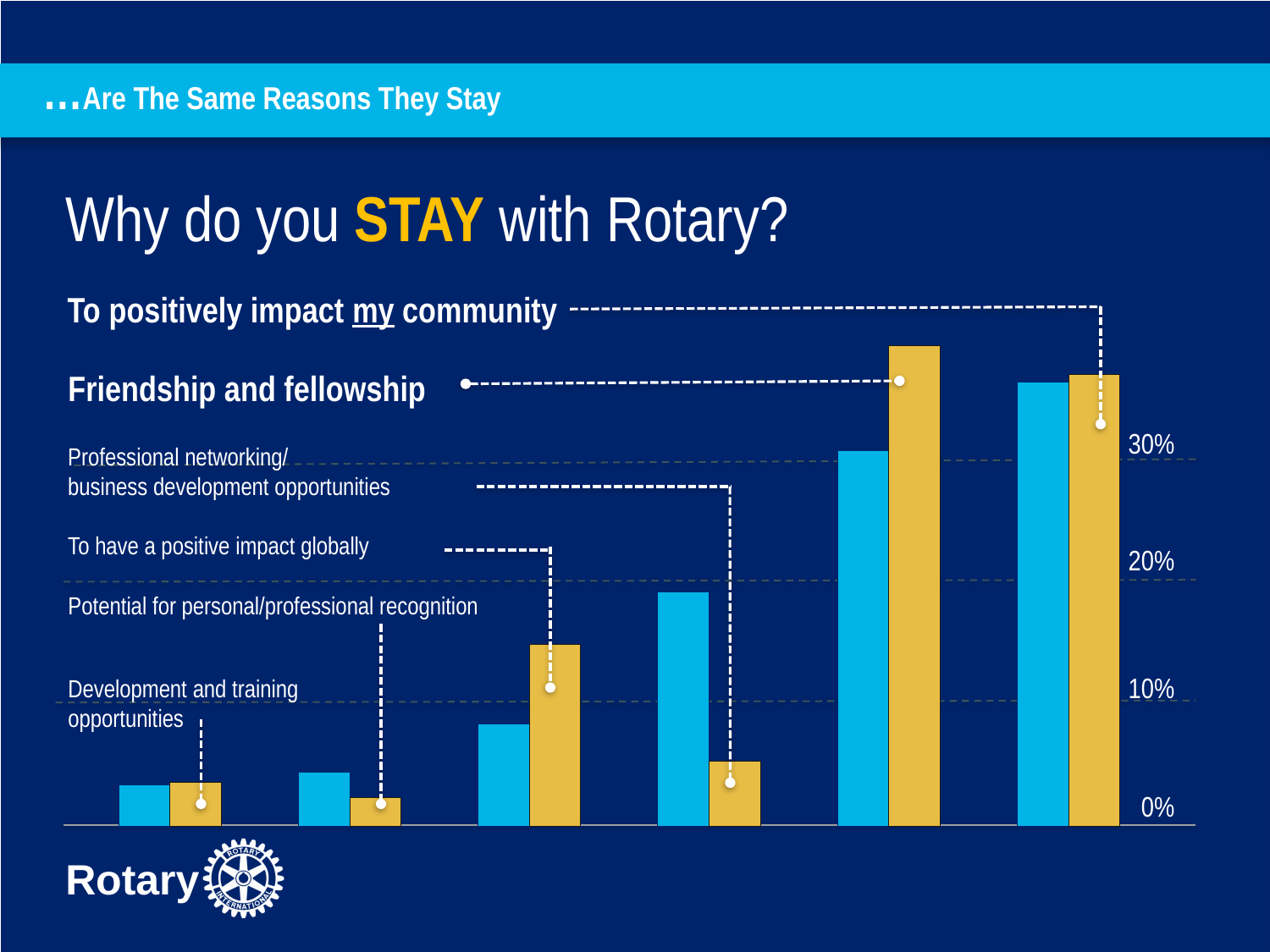
Is the gold bar for 'Professional networking/business development opportunities' greater or less than 10%? less For 'Professional networking/business development opportunities', which bar is taller, the blue one or the gold one? blue For 'Friendship and fellowship', which bar is taller, the blue one or the gold one? gold What is the highest percentage tick shown on the chart's axis? 30% What kind of chart is shown on the slide? bar chart Is the blue bar for 'To have a positive impact globally' greater or less than 10%? less How many reasons (categories) are plotted in the chart? 6 Which reason has the tallest blue bar? To positively impact my community Is the blue bar for 'Professional networking/business development opportunities' greater or less than 10%? greater Which reason has the tallest gold bar? Friendship and fellowship